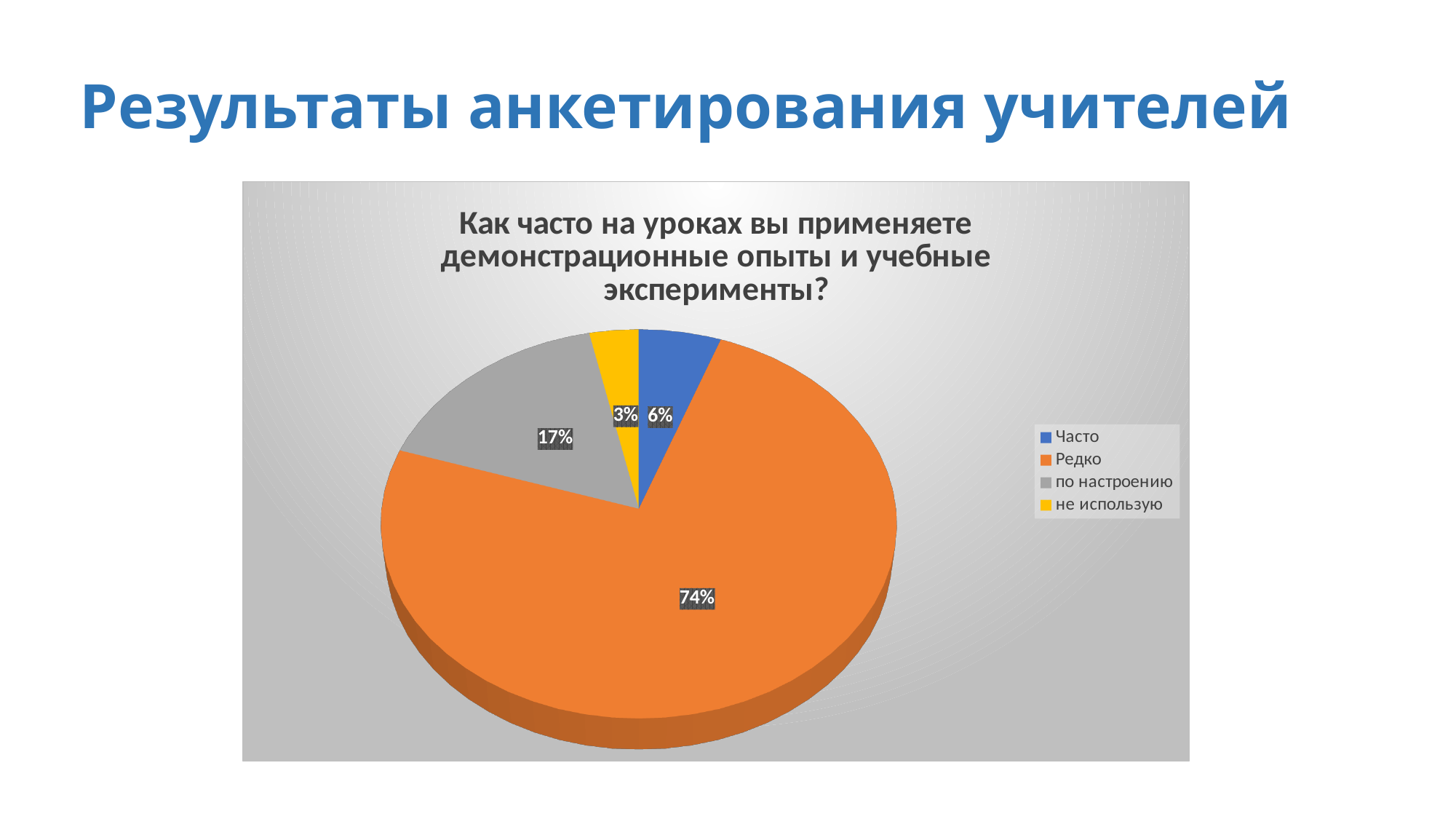
What percentage of teachers answered "Часто"? 6% Which answer has the largest share of the pie? Редко What colour is the slice for "Редко"? Orange What is the title of the chart? Как часто на уроках вы применяете демонстрационные опыты и учебные эксперименты? Which is larger, the share for "Часто" or the share for "по настроению"? по настроению How many categories does the legend list? 4 Which answer has the smallest share of the pie? не использую What kind of chart is shown on the slide? Pie chart What is the difference in percentage points between "Редко" and "по настроению"? 57 What percentage of teachers answered "Редко"? 74% What percentage of teachers answered "по настроению"? 17% What percentage of teachers answered "не использую"? 3%